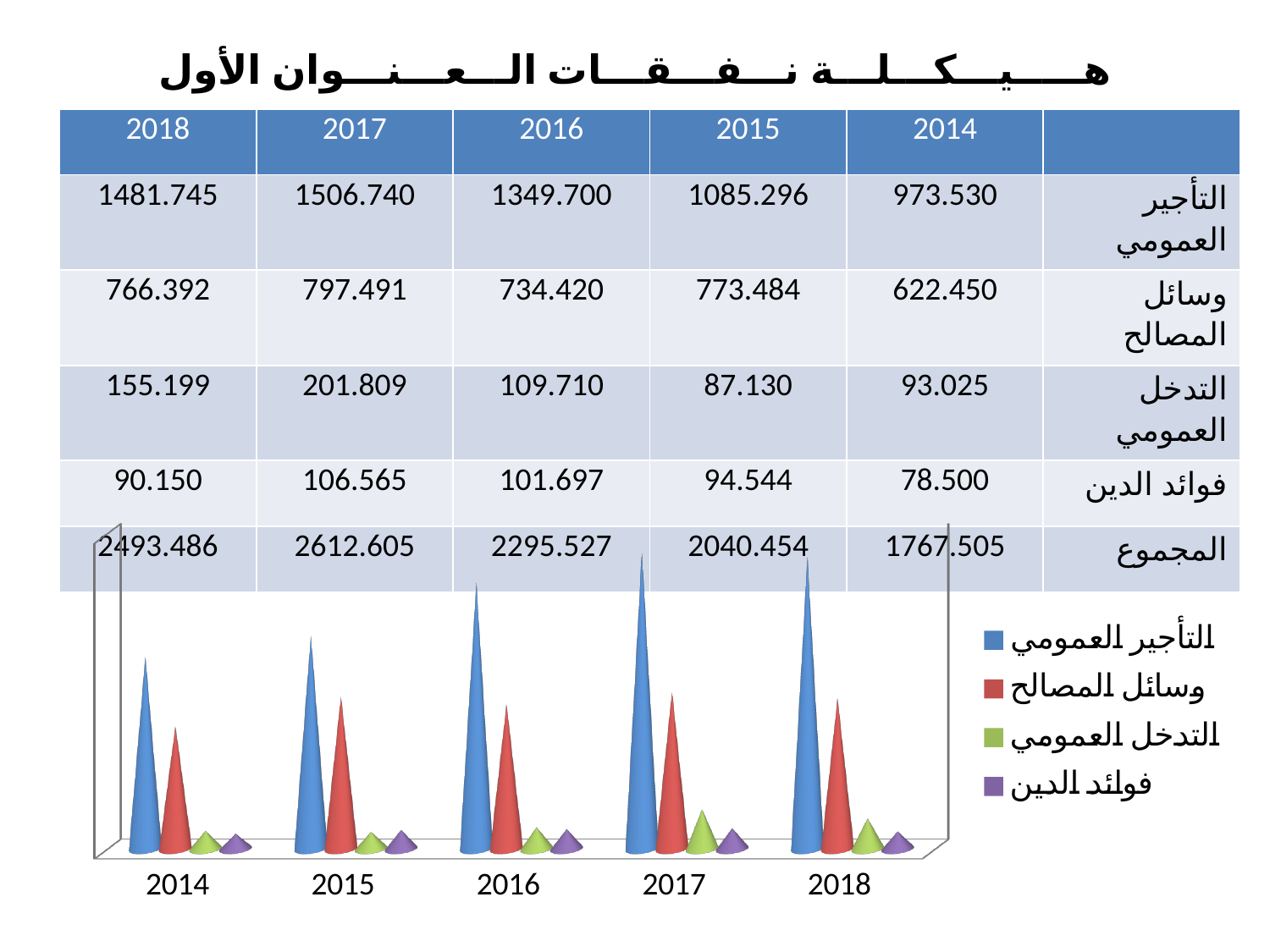
How many years (categories) are shown along the x axis of the chart? 5 In 2017, which is larger: وسائل المصالح or التدخل العمومي? وسائل المصالح Which series is represented by the purple cones in the chart? فوائد الدين What kind of chart is shown on the slide? bar chart Which series has the highest value in every year shown? التأجير العمومي How many series does the chart legend list? 4 Does the value for التأجير العمومي rise or fall from 2014 to 2017? rise In which year is the value for التأجير العمومي the lowest? 2014 According to the table on the slide, what is the value for التأجير العمومي in 2014? 973.530 According to the table on the slide, what is the total (المجموع) for 2018? 2493.486 In 2016, which is larger: التأجير العمومي or وسائل المصالح? التأجير العمومي Which series is represented by the blue cones in the chart? التأجير العمومي